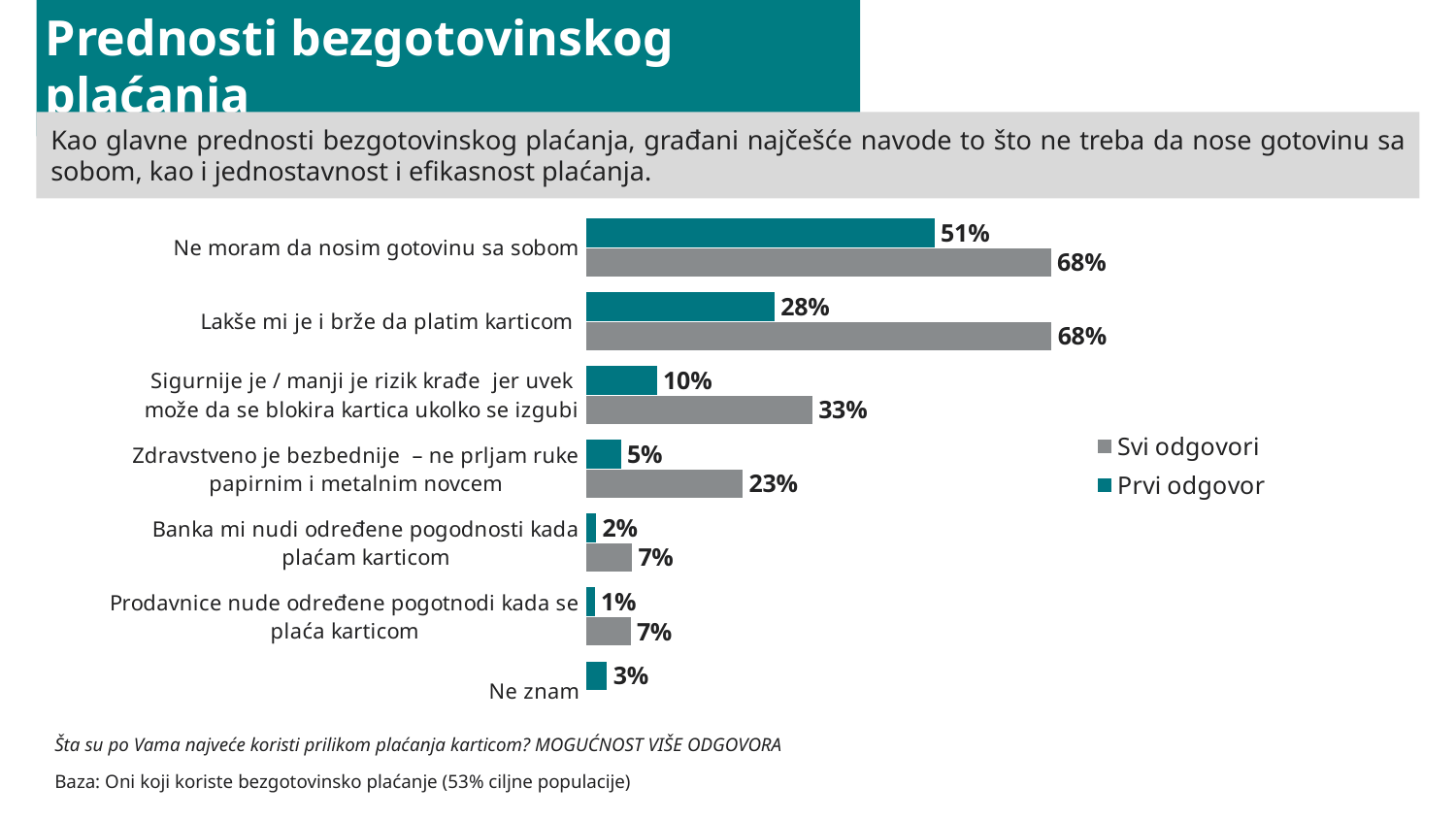
Which is larger: the 'Prvi odgovor' value for 'Zdravstveno je bezbednije' or for 'Banka mi nudi određene pogodnosti kada plaćam karticom'? Zdravstveno je bezbednije What type of chart is shown on the slide? bar chart How many categories are shown on the chart? 7 What is the 'Prvi odgovor' value for 'Lakše mi je i brže da platim karticom'? 28% Which category has the highest 'Prvi odgovor' value? Ne moram da nosim gotovinu sa sobom How many series does the legend list? 2 What is the difference between the 'Svi odgovori' and 'Prvi odgovor' values for 'Lakše mi je i brže da platim karticom'? 40% Which category has the lowest 'Prvi odgovor' value? Prodavnice nude određene pogotnodi kada se plaća karticom What is the 'Prvi odgovor' value for 'Ne znam'? 3% What is the 'Svi odgovori' value for 'Sigurnije je / manji je rizik krađe jer uvek može da se blokira kartica ukolko se izgubi'? 33% What is the 'Svi odgovori' value for 'Ne moram da nosim gotovinu sa sobom'? 68% What is the difference between the 'Svi odgovori' values for 'Sigurnije je / manji je rizik krađe' and 'Zdravstveno je bezbednije'? 10%